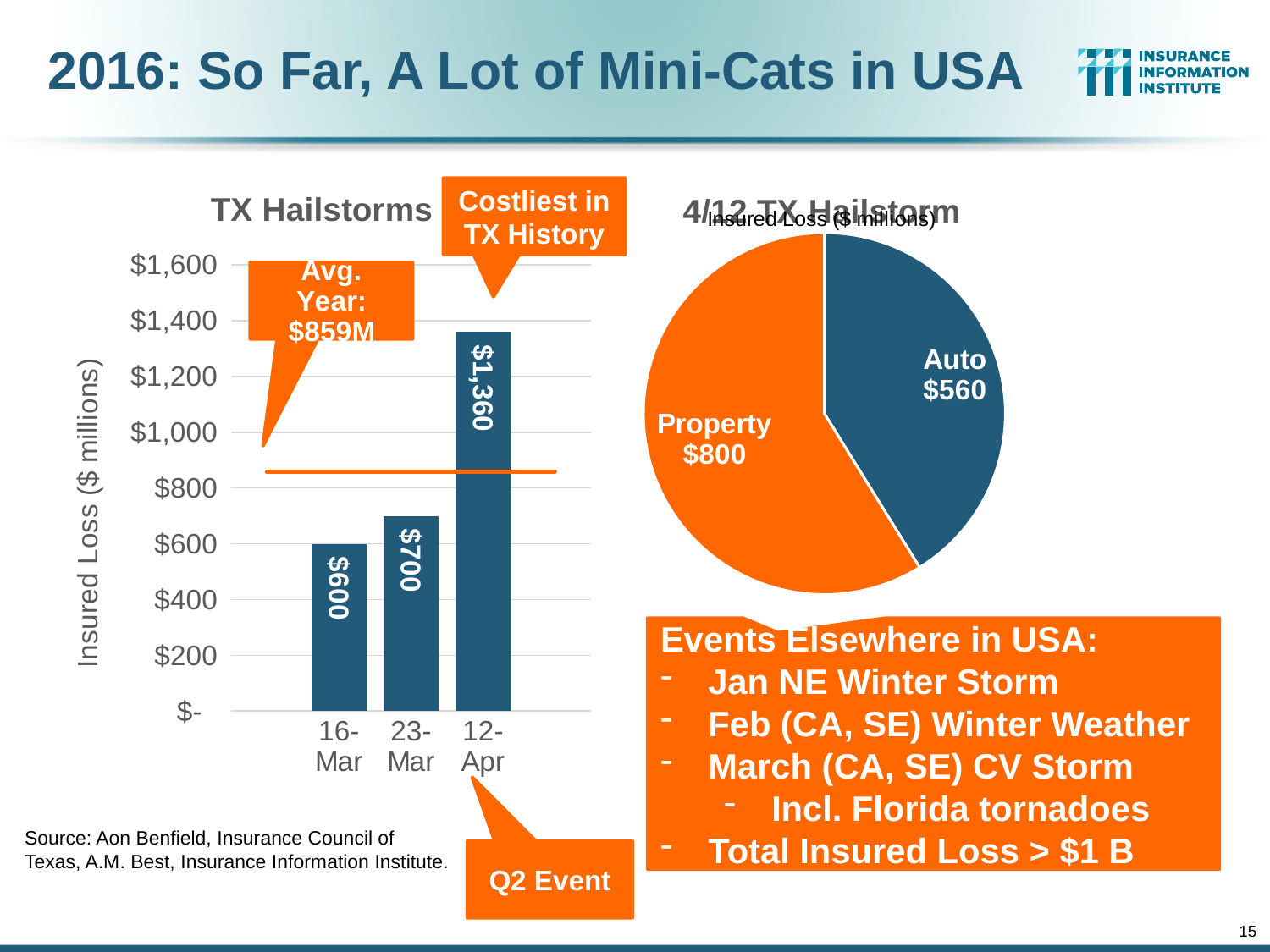
In the TX Hailstorms bar chart, how many events are plotted? 3 What is the y-axis label of the TX Hailstorms bar chart? Insured Loss ($ millions) In the TX Hailstorms bar chart, what is the insured loss for the 16-Mar event? $600 In the TX Hailstorms bar chart, which event has the highest insured loss? 12-Apr In the TX Hailstorms bar chart, what is the difference between the insured loss for 12-Apr and 23-Mar? $660 In the 4/12 TX Hailstorm pie chart, what is the insured loss for Property? $800 What kind of chart is the TX Hailstorms chart? Bar chart In the 4/12 TX Hailstorm pie chart, what is the difference between the Property and Auto insured losses? $240 In the TX Hailstorms bar chart, which event has the lowest insured loss? 16-Mar In the TX Hailstorms bar chart, do the insured losses rise or fall from 16-Mar to 12-Apr? Rise In the 4/12 TX Hailstorm pie chart, which is larger, Auto or Property? Property In the TX Hailstorms bar chart, what is the insured loss for the 12-Apr event? $1,360